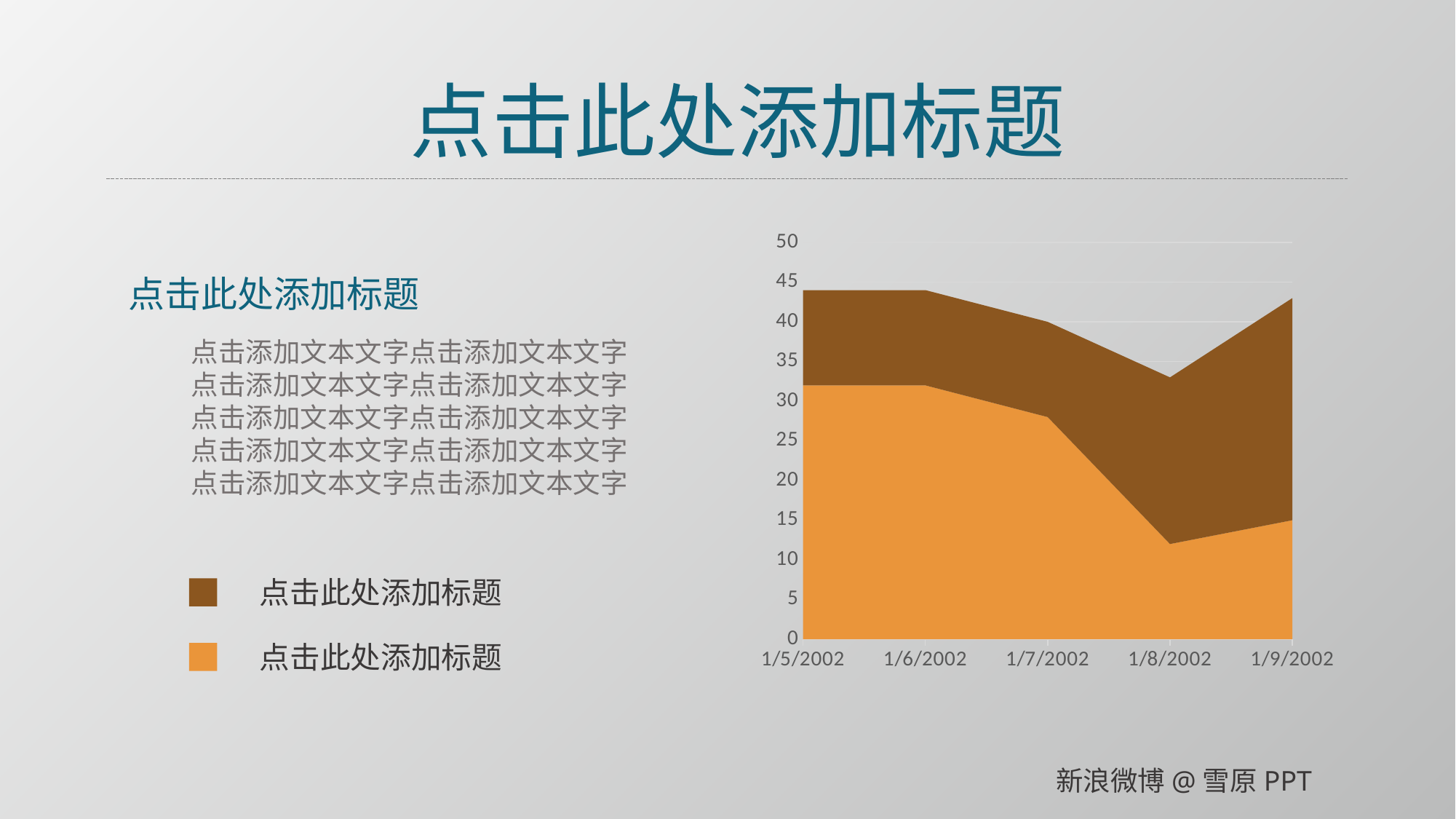
Does the orange (bottom) series rise or fall from 1/5/2002 to 1/8/2002? fall Is the orange (bottom) series larger at 1/5/2002 or at 1/8/2002? 1/5/2002 At which date is the combined stacked total at its lowest? 1/8/2002 How many dates are shown along the x axis of the chart? 5 Is the value of the orange (bottom) series at 1/8/2002 greater or less than 15? less What kind of chart is shown on the slide? Area chart Is the top of the stacked area at 1/8/2002 greater or less than 40? less Is the value of the orange (bottom) series at 1/5/2002 greater or less than 30? greater What is the highest tick value shown on the chart's y axis? 50 At which date is the orange (bottom) series at its lowest? 1/8/2002 How many series does the chart's legend list? 2